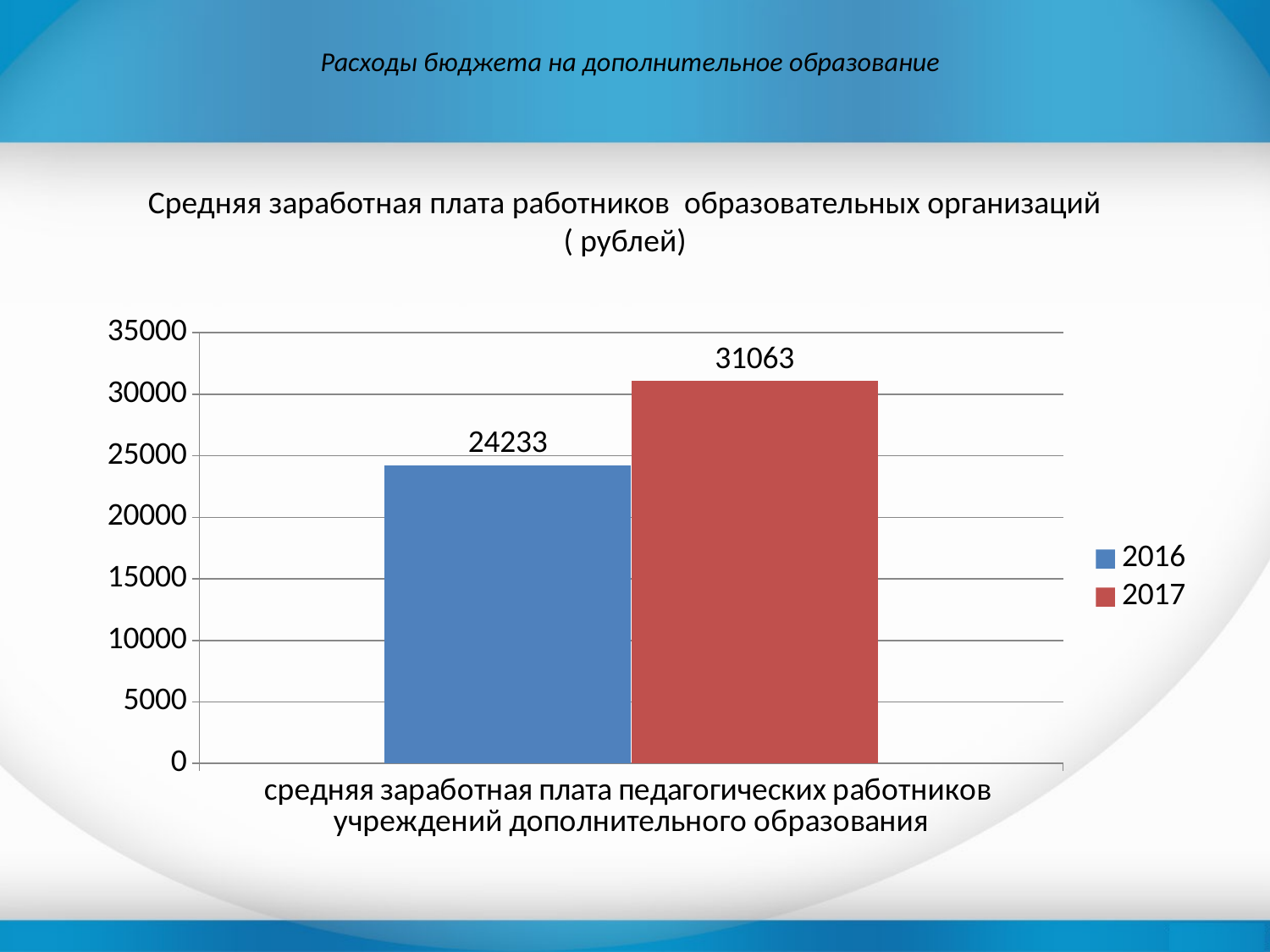
What is the value for 2017? 31063 What is the difference between the 2017 and 2016 values? 6830 Which year has the higher value, 2016 or 2017? 2017 What colour is the bar for 2017? red How many categories are shown on the x axis? 1 What is the title of the chart? Средняя заработная плата работников образовательных организаций ( рублей) What is the value for 2016? 24233 What kind of chart is shown? bar chart Which series has the lowest value? 2016 Is the value for 2016 greater or less than 25000? less How many series does the legend list? 2 Is the value for 2017 greater or less than 30000? greater